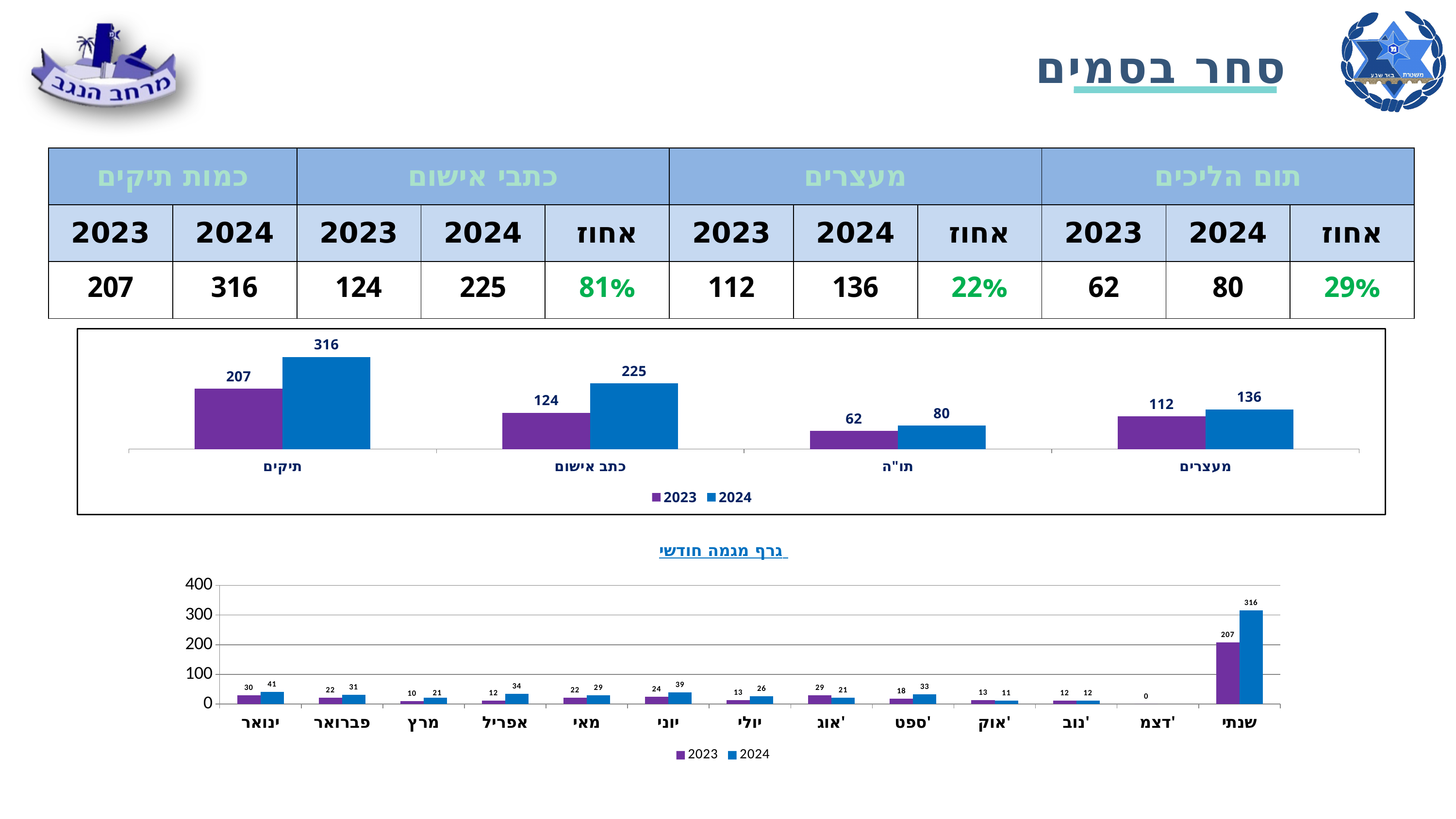
What kind of chart is the chart titled גרף מגמה חודשי? Bar chart In the chart titled גרף מגמה חודשי, what is the 2024 value for אפריל? 34 In the upper bar chart, which category has the lowest 2023 value? תו"ה In the upper bar chart, what is the difference between the 2024 and 2023 values for מעצרים? 24 In the chart titled גרף מגמה חודשי, what is the highest value shown on the y axis? 400 In the chart titled גרף מגמה חודשי, how many series does the legend list? 2 In the upper bar chart, what is the 2024 value for תיקים? 316 In the upper bar chart, how many categories are shown on the x axis? 4 In the chart titled גרף מגמה חודשי, what is the difference between the 2024 and 2023 values for שנתי? 109 In the upper bar chart, what is the 2023 value for כתב אישום? 124 In the chart titled גרף מגמה חודשי, which is larger for יוני: the 2023 value or the 2024 value? 2024 In the chart titled גרף מגמה חודשי, what is the 2023 value for אוג'? 29